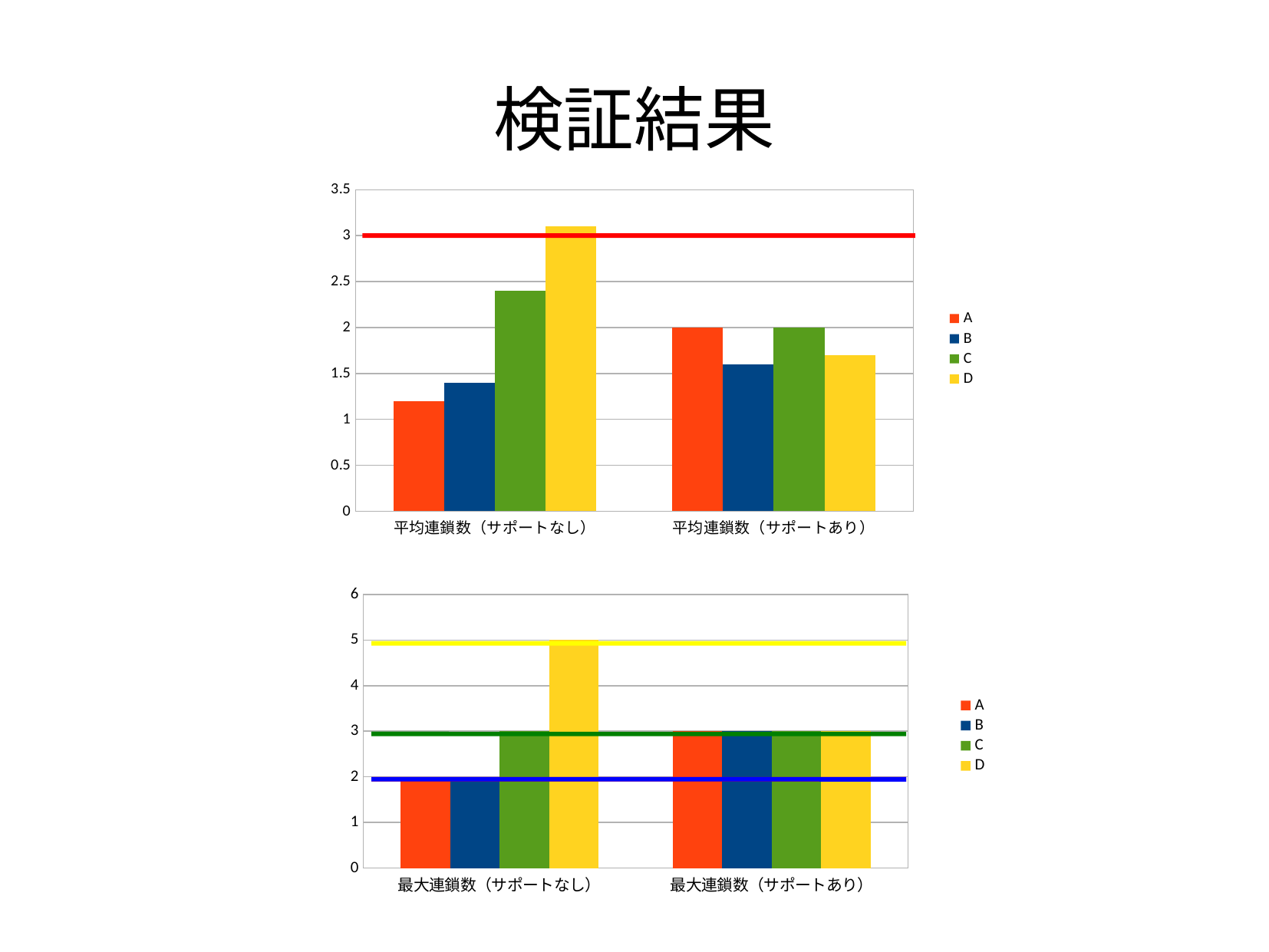
How many series does the legend of the top chart list? 4 What kind of chart is the top chart on the slide? bar chart In the bottom chart, which series has the highest value for 最大連鎖数（サポートなし）? D How many categories are shown on the x axis of the bottom chart? 2 In the bottom chart, what is the value of series C for 最大連鎖数（サポートなし）? 3 In the top chart, is the value of series D for 平均連鎖数（サポートなし） greater or less than 3? greater In the bottom chart, what is the difference between series D and series A for 最大連鎖数（サポートなし）? 3 In the top chart, which is larger for 平均連鎖数（サポートあり）: series A or series B? A In the top chart, is the value of series C for 平均連鎖数（サポートなし） greater or less than 2? greater In the top chart, which series has the highest value for 平均連鎖数（サポートなし）? D In the top chart, which series has the lowest value for 平均連鎖数（サポートなし）? A In the bottom chart, what is the value of series D for 最大連鎖数（サポートなし）? 5